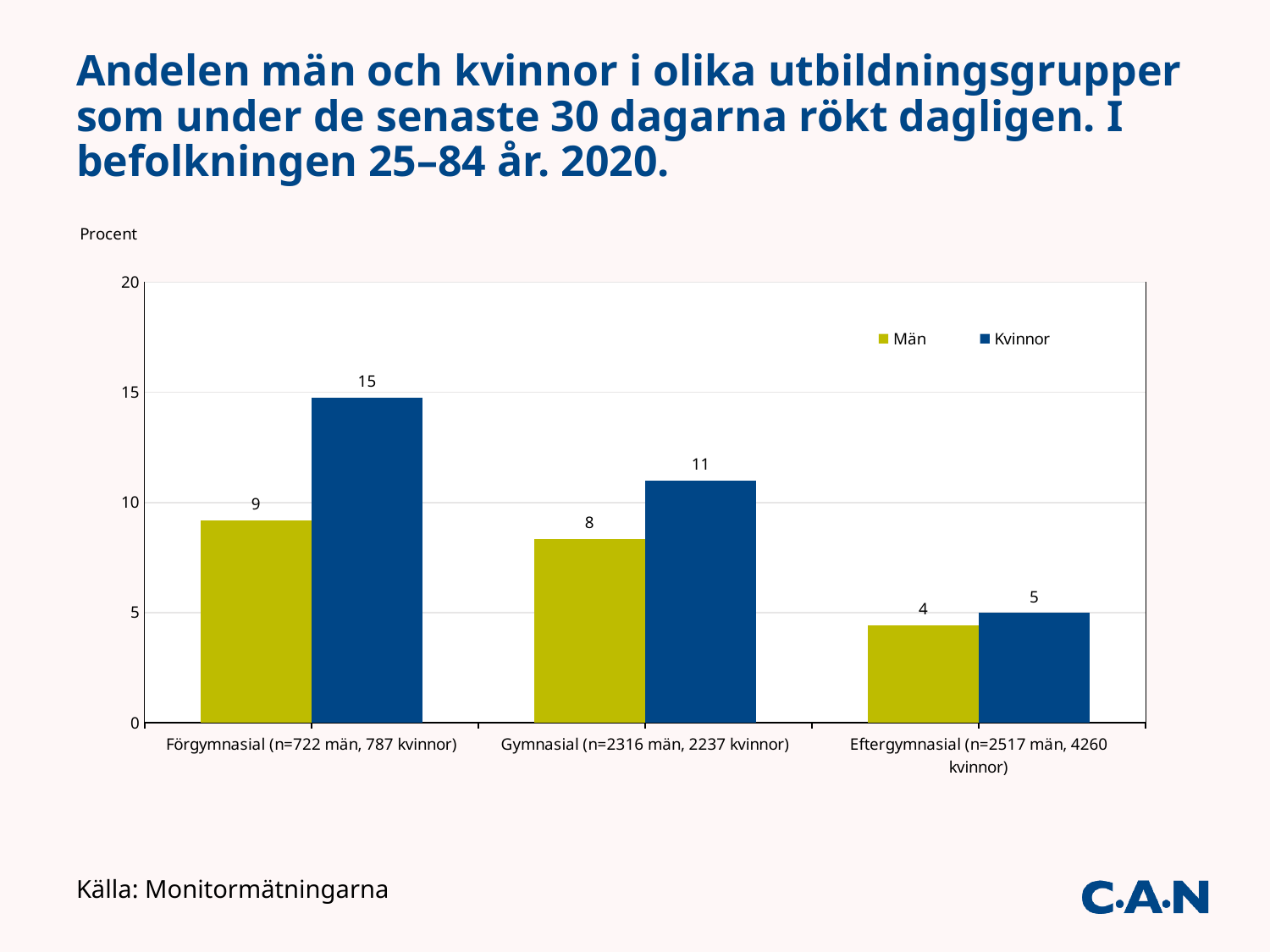
What is the label on the y axis? Procent Which is larger in the Gymnasial group, Män or Kvinnor? Kvinnor What kind of chart is shown on the slide? Bar chart What is the value for Män in the Gymnasial group? 8 Which education group has the lowest value for Män? Eftergymnasial What is the difference between Kvinnor and Män in the Förgymnasial group? 6 How many series does the legend list? 2 Which education group has the highest value for Kvinnor? Förgymnasial What is the value for Kvinnor in the Eftergymnasial group? 5 What is the value for Kvinnor in the Förgymnasial group? 15 How many education groups are shown on the x axis? 3 Is the value for Kvinnor in the Gymnasial group greater or less than 10? greater